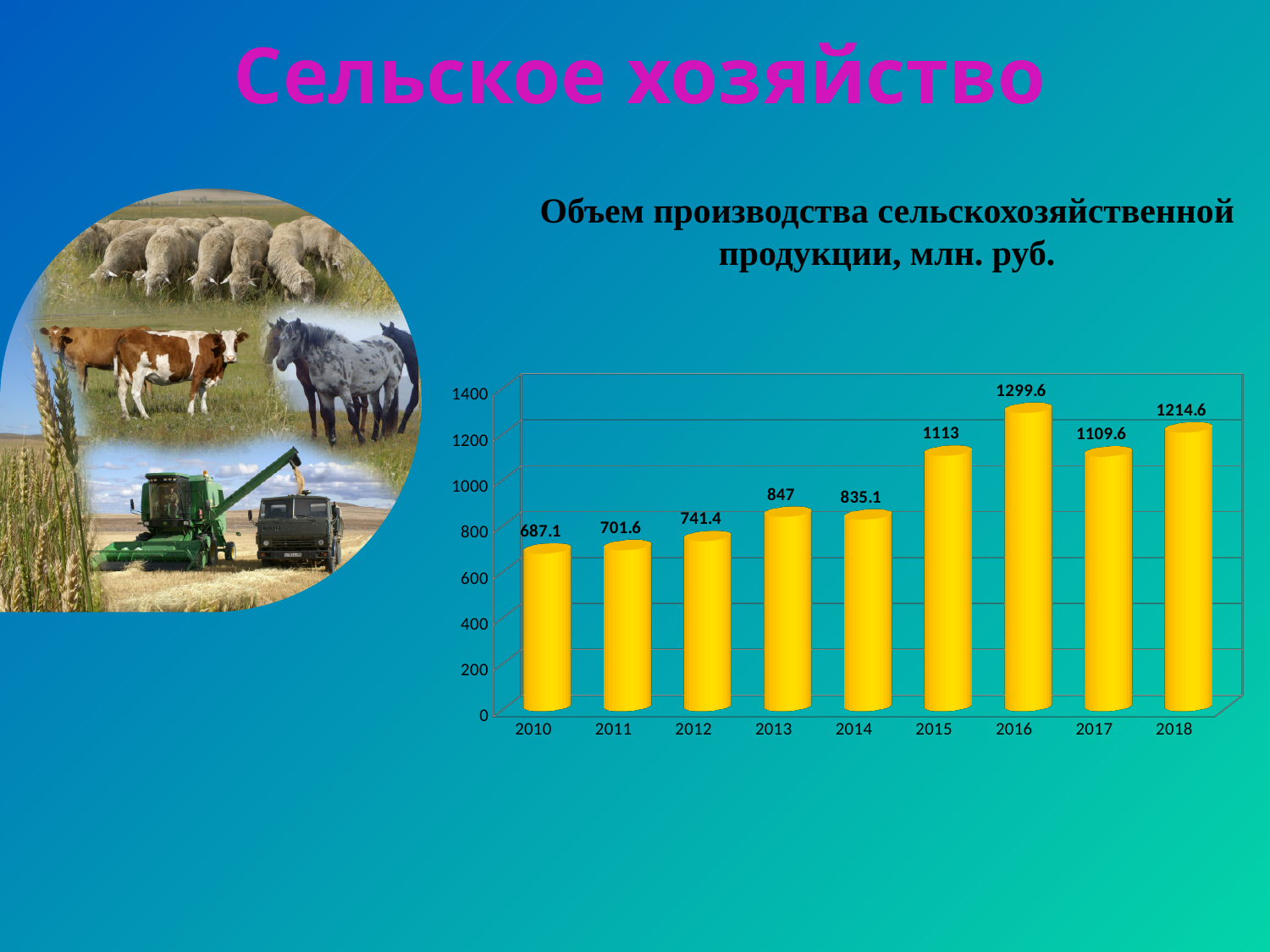
What is the value for 2010? 687.1 Do the values generally rise or fall from 2010 to 2016? rise What is the value for 2016? 1299.6 What is the title of the chart? Объем производства сельскохозяйственной продукции, млн. руб. Which is larger, the value for 2013 or the value for 2014? 2013 How many years are shown on the x axis? 9 Which year has the highest value? 2016 What is the difference between the values for 2018 and 2017? 105 What is the value for 2013? 847 What kind of chart is shown on the slide? bar chart Is the value for 2015 greater or less than 1000? greater Which year has the lowest value? 2010